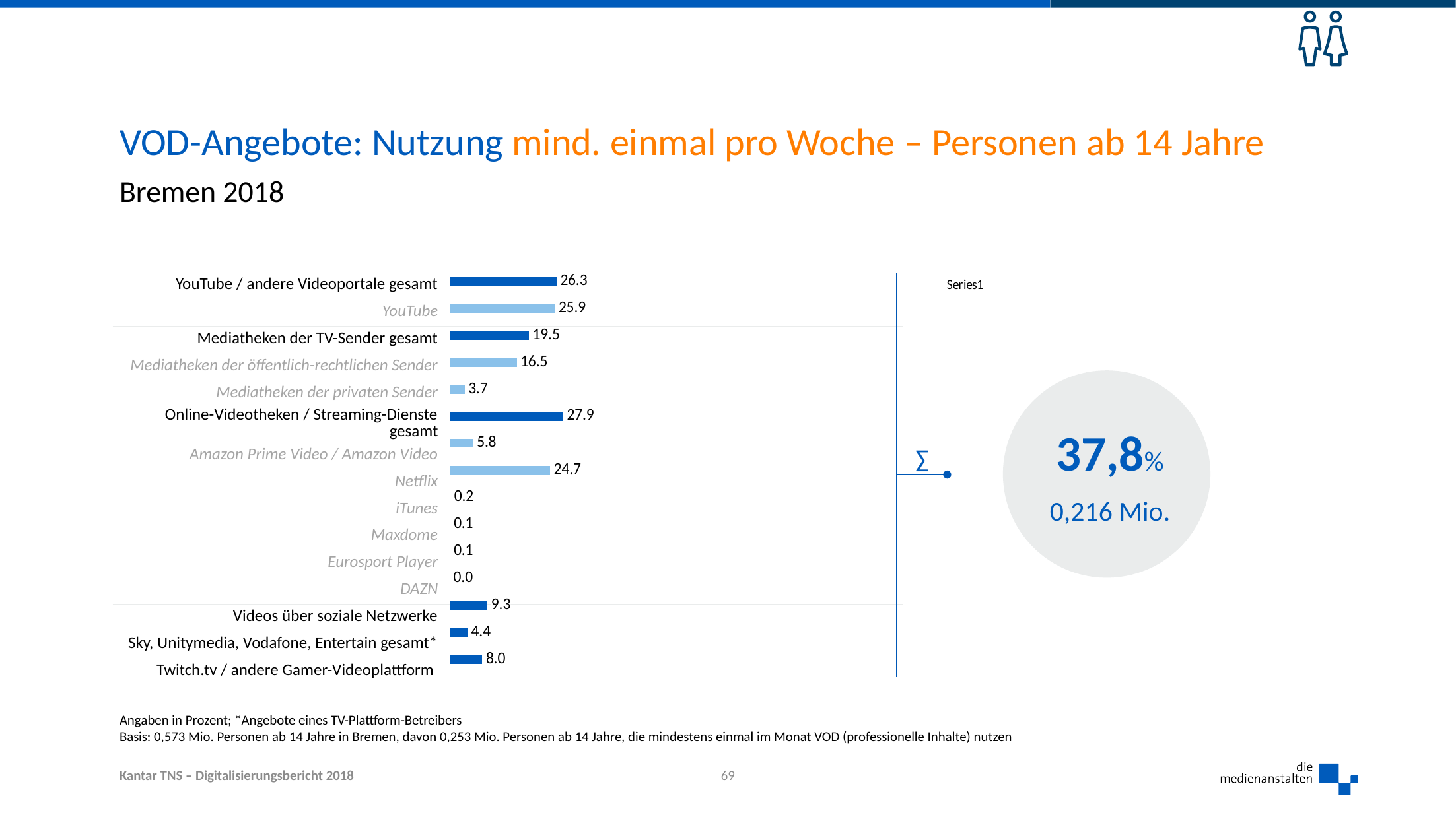
What is the value for Amazon Prime Video / Amazon Video? 5.8 What is the difference between YouTube / andere Videoportale gesamt and YouTube? 0.4 What is the value for Mediatheken der TV-Sender gesamt? 19.5 Which category has the lowest value? DAZN What percentage is shown in the grey circle to the right of the chart? 37,8% What is the difference between Mediatheken der öffentlich-rechtlichen Sender and Mediatheken der privaten Sender? 12.8 Which is larger, the value for Videos über soziale Netzwerke or the value for Twitch.tv / andere Gamer-Videoplattform? Videos über soziale Netzwerke How many categories are shown in the bar chart? 15 What is the value for Twitch.tv / andere Gamer-Videoplattform? 8.0 What is the value for Netflix? 24.7 Which category has the highest value? Online-Videotheken / Streaming-Dienste gesamt What kind of chart is shown on the slide? Bar chart